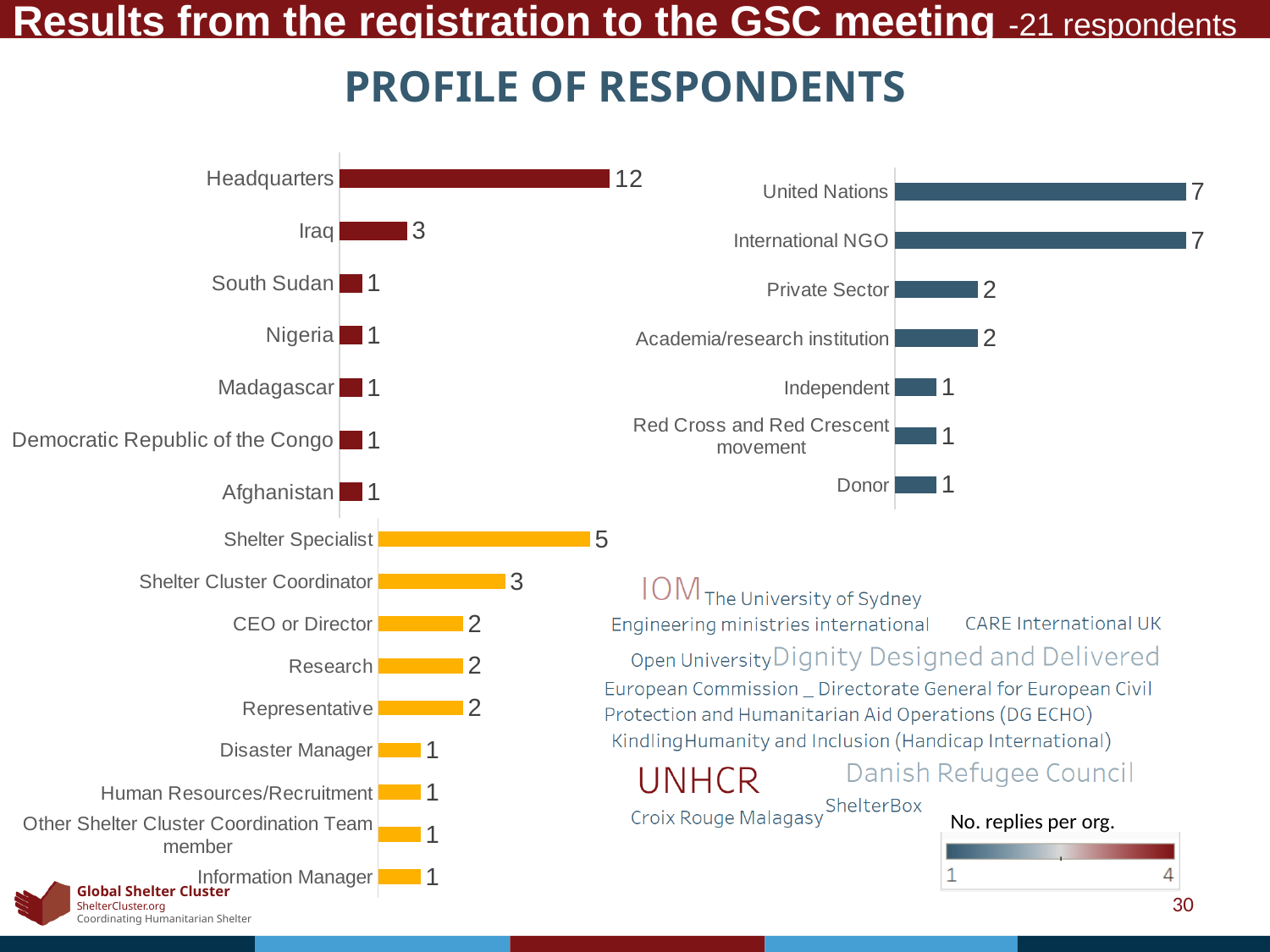
What type of chart is the top-right chart of organisation types? Bar chart In the top-right chart of organisation types, what is the value for Private Sector? 2 In the top-right chart of organisation types, which two categories share the highest value? United Nations and International NGO In the top-left chart of locations, how many locations are listed? 7 In the top-left chart of locations, which location has the highest number of respondents? Headquarters In the bottom-left chart of roles, what is the value for Shelter Specialist? 5 In the top-left chart of locations, how many respondents are from Headquarters? 12 In the bottom-left chart of roles, which is larger: Shelter Cluster Coordinator or CEO or Director? Shelter Cluster Coordinator In the top-right chart of organisation types, how many categories are shown? 7 In the top-left chart of locations, what is the value for Iraq? 3 In the top-left chart of locations, what is the difference between Headquarters and Iraq? 9 In the bottom-left chart of roles, which role has the highest number of respondents? Shelter Specialist